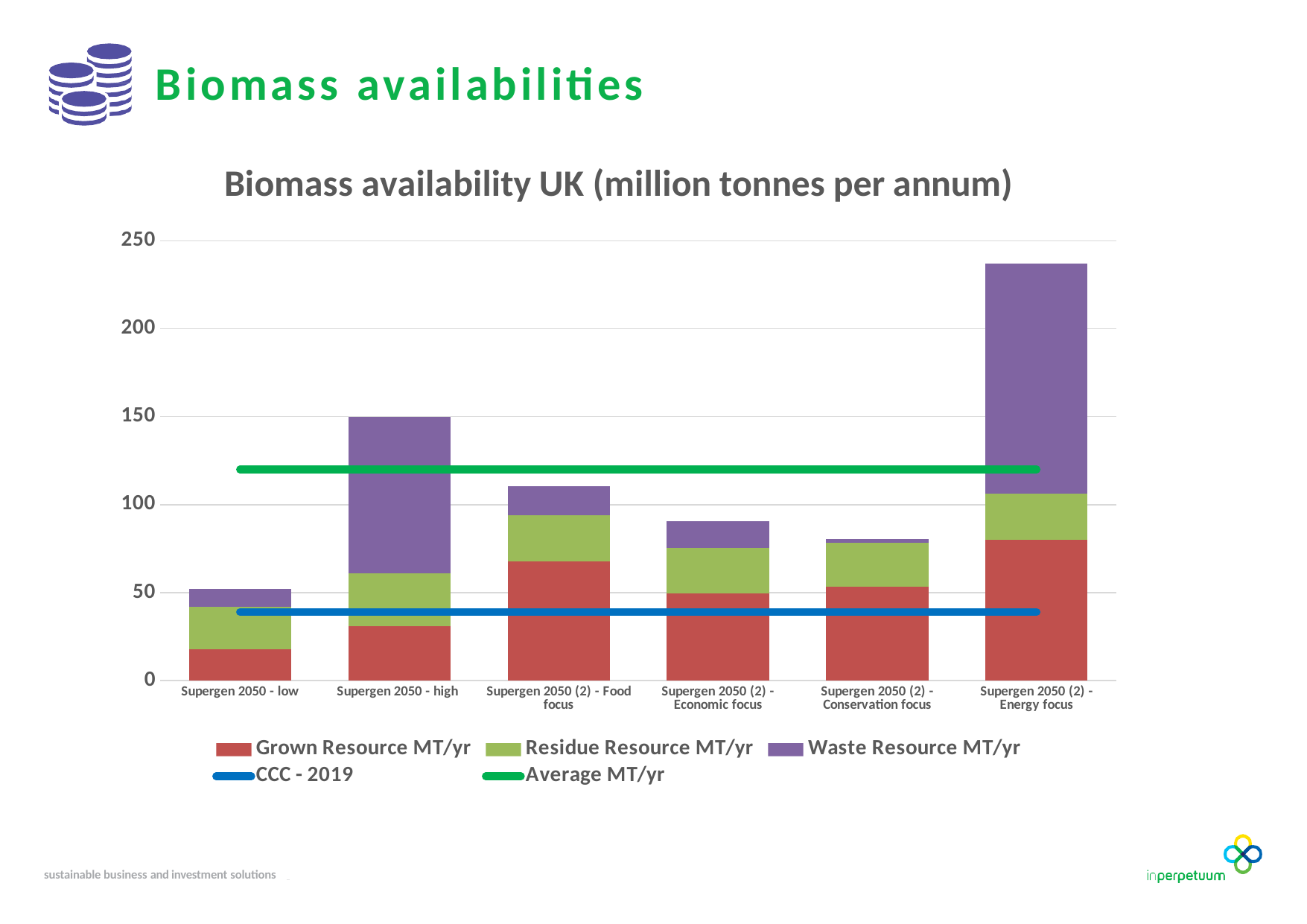
What is the title of the chart? Biomass availability UK (million tonnes per annum) Which scenario has the highest total biomass availability? Supergen 2050 (2) - Energy focus What kind of chart is shown on the slide? stacked bar chart with line series (combination bar and line chart) Which scenario has the lowest total biomass availability? Supergen 2050 - low Which has the larger total: Supergen 2050 - high or Supergen 2050 (2) - Food focus? Supergen 2050 - high Is the total for Supergen 2050 (2) - Economic focus greater or less than 100? less Is the total for Supergen 2050 (2) - Energy focus greater or less than 200? greater Is the Average MT/yr line greater or less than 100? greater How many series does the legend list? 5 How many scenario categories are shown along the x axis? 6